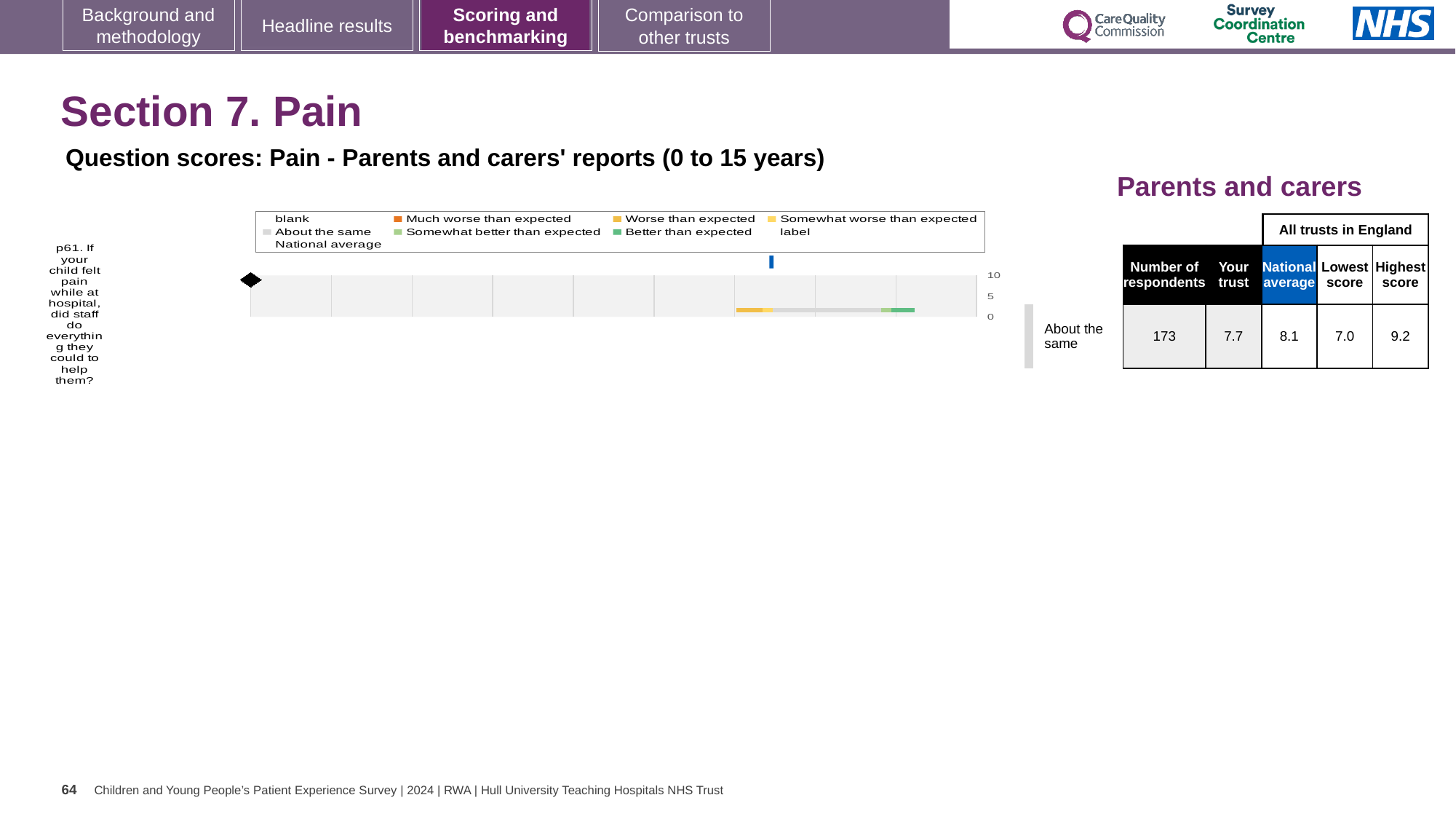
By how much does the national average exceed the trust's score for question p61? 0.4 What kind of chart is shown on the slide? bar chart How many respondents answered question p61? 173 What is the 'Your trust' score for question p61? 7.7 Which benchmarking category does the trust's result for question p61 fall into? About the same Is the trust's score for question p61 higher or lower than the national average? lower What is the lowest score among all trusts in England for question p61? 7.0 What is the national average score for question p61? 8.1 What is the question number of the item plotted in the chart? p61 What is the highest score among all trusts in England for question p61? 9.2 What is the difference between the highest and lowest scores for question p61? 2.2 How many survey questions are plotted in the chart? 1